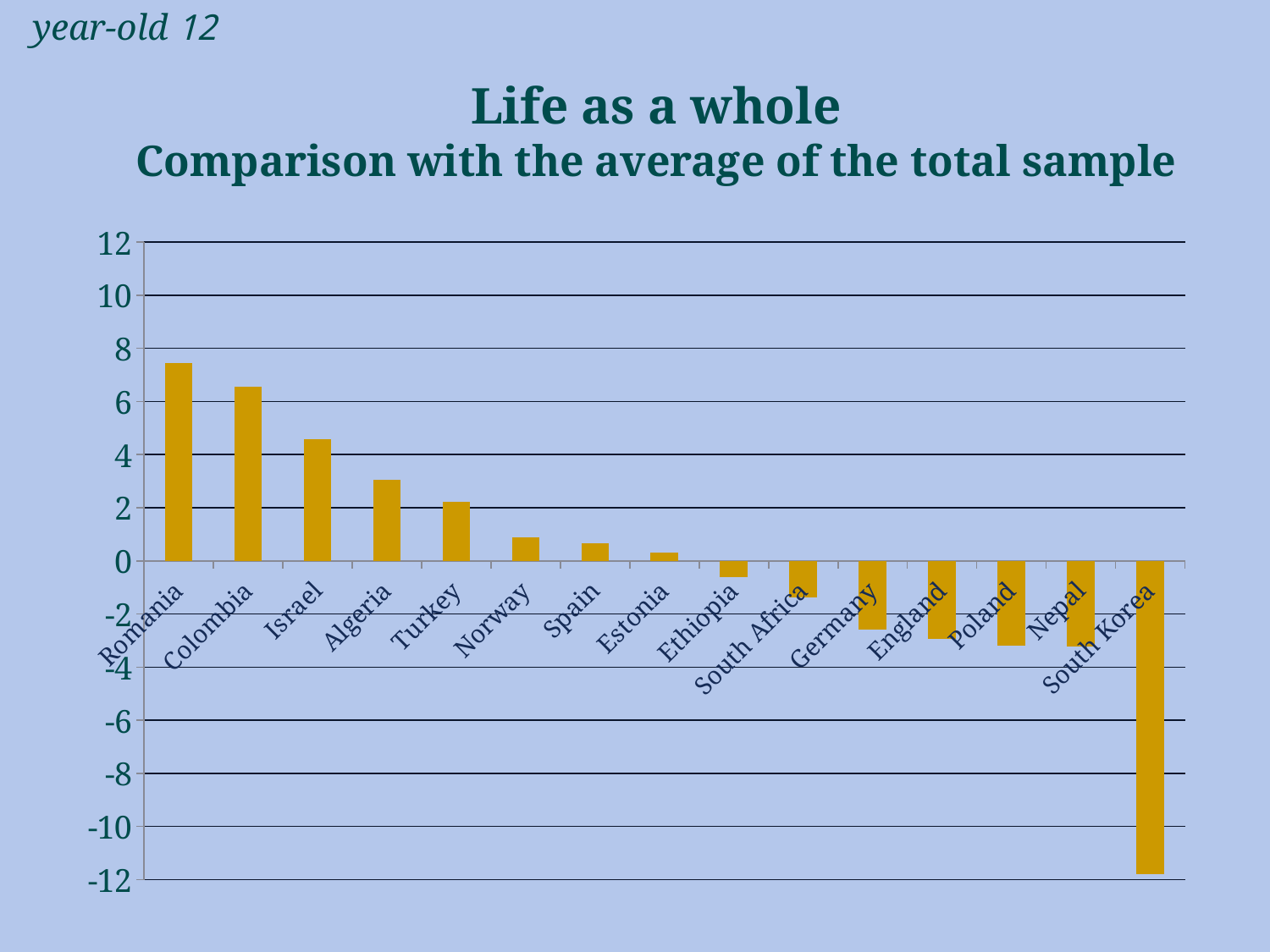
Is the value for Turkey greater or less than 4? less Which country has the highest value in the chart? Romania Is the value for Israel greater or less than 4? greater How many countries are shown on the x axis of the chart? 15 What kind of chart is shown on the slide? bar chart Is the value for South Korea greater or less than -10? less Which has the larger value, Norway or Germany? Norway What is the title of the chart? Life as a whole Comparison with the average of the total sample Which has the larger value, Colombia or Algeria? Colombia Do the values rise or fall moving from left to right along the x axis? fall Which country has the lowest value in the chart? South Korea